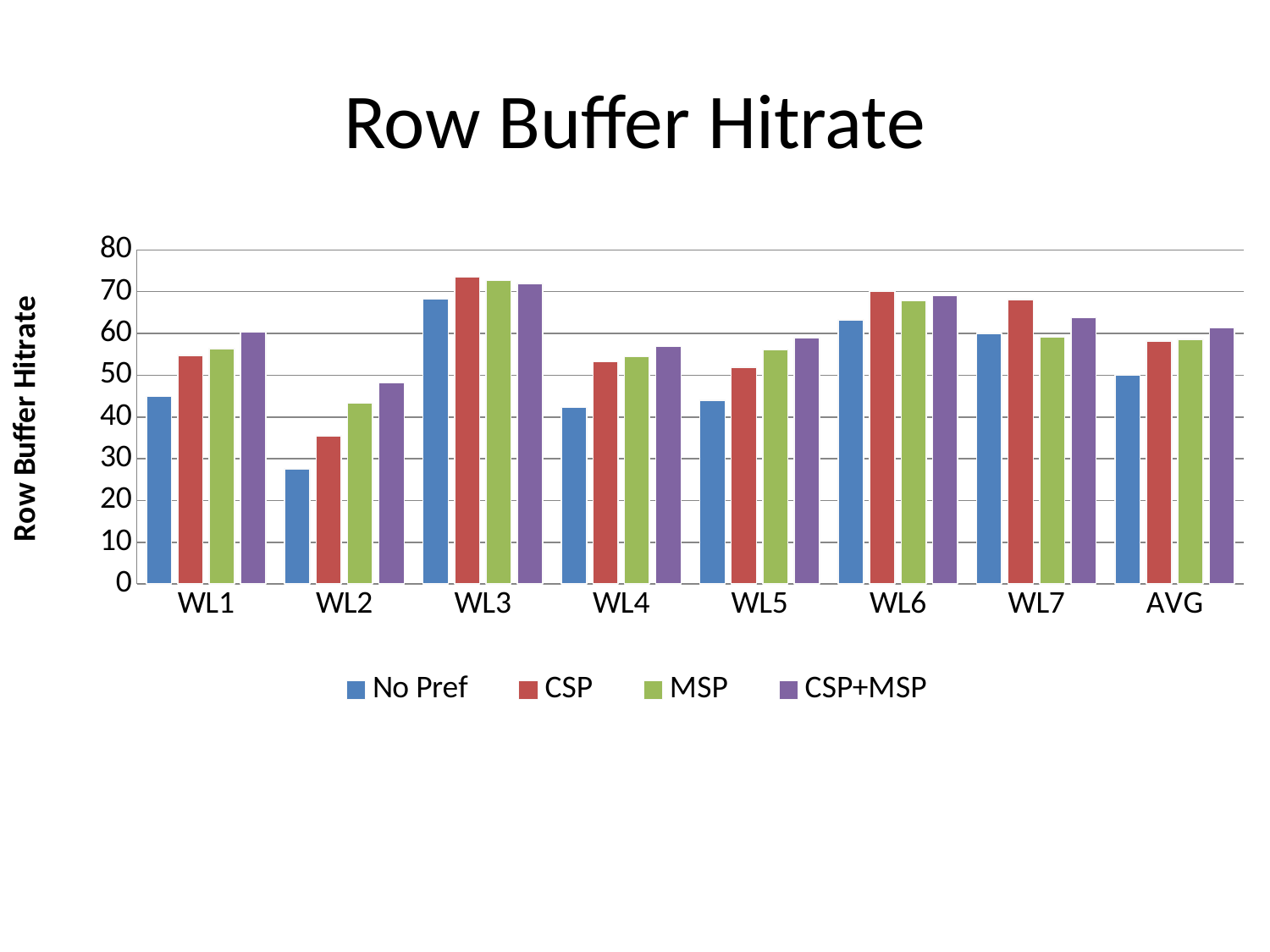
What is the title of the y axis? Row Buffer Hitrate Which category has the highest CSP value? WL3 What kind of chart is shown on the slide? bar chart How many categories are shown on the x axis? 8 For WL2, which is larger: the No Pref value or the CSP+MSP value? CSP+MSP Which category has the highest No Pref value? WL3 Is the CSP value for WL3 greater or less than 70? greater For WL7, which is larger: the CSP value or the MSP value? CSP Is the No Pref value for WL2 greater or less than 30? less How many series does the legend list? 4 Is the No Pref value for WL4 greater or less than 50? less Which category has the lowest No Pref value? WL2